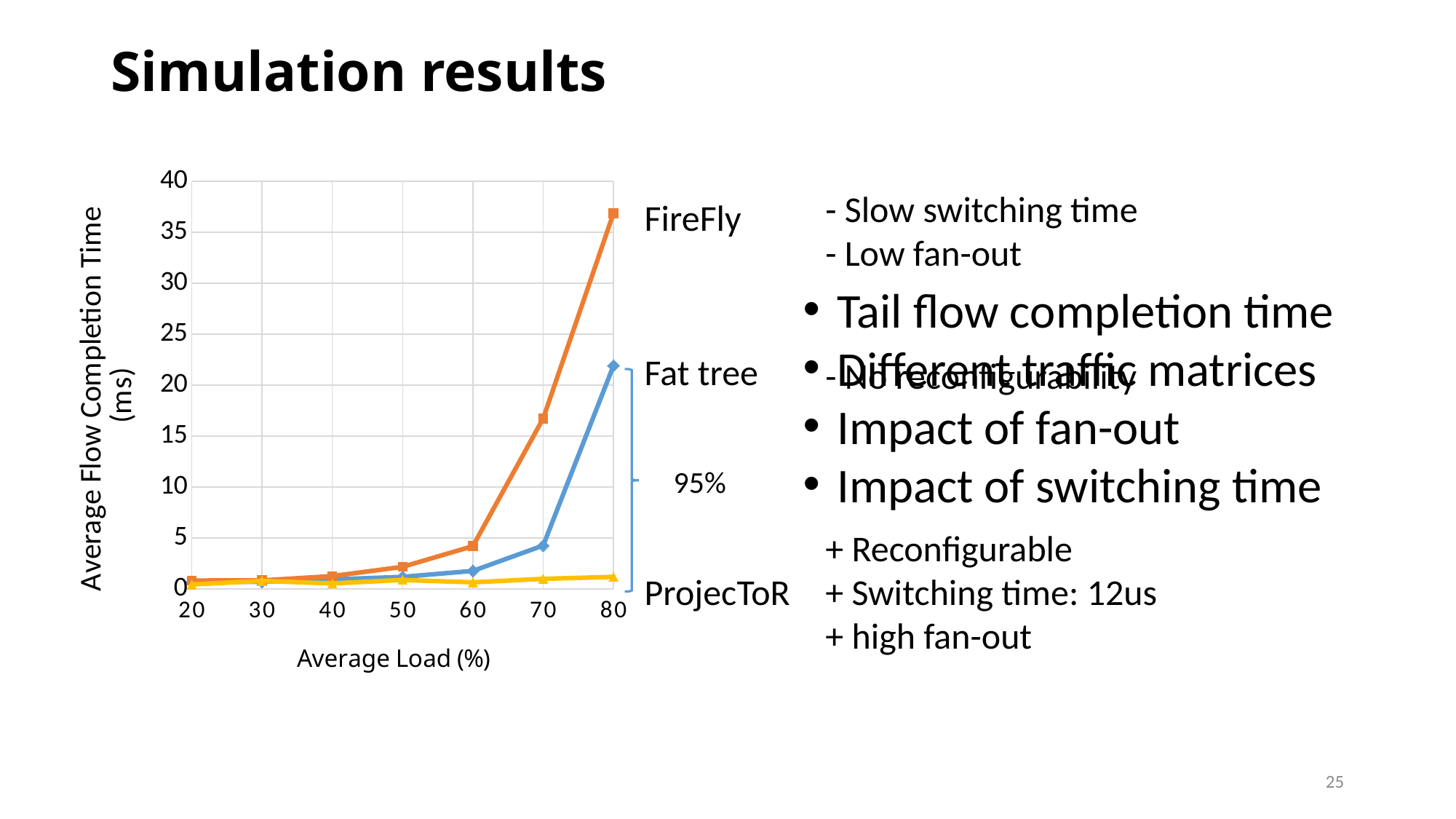
What is the title of the y axis? Average Flow Completion Time (ms) Which series has the highest average flow completion time at 80% load? FireFly Is the value for FireFly at 80% load greater or less than 30? greater How many series are plotted on the chart? 3 Is the value for ProjecToR at 80% load greater or less than 5? less Is the value for Fat tree at 80% load greater or less than 20? greater How many load values are plotted along the x axis? 7 What kind of chart is shown on the slide? line chart At 70% load, which is larger: the value for FireFly or the value for Fat tree? FireFly Which series has the lowest average flow completion time at 80% load? ProjecToR Does the FireFly line rise or fall as average load increases from 20% to 80%? rises What is the title of the x axis? Average Load (%)